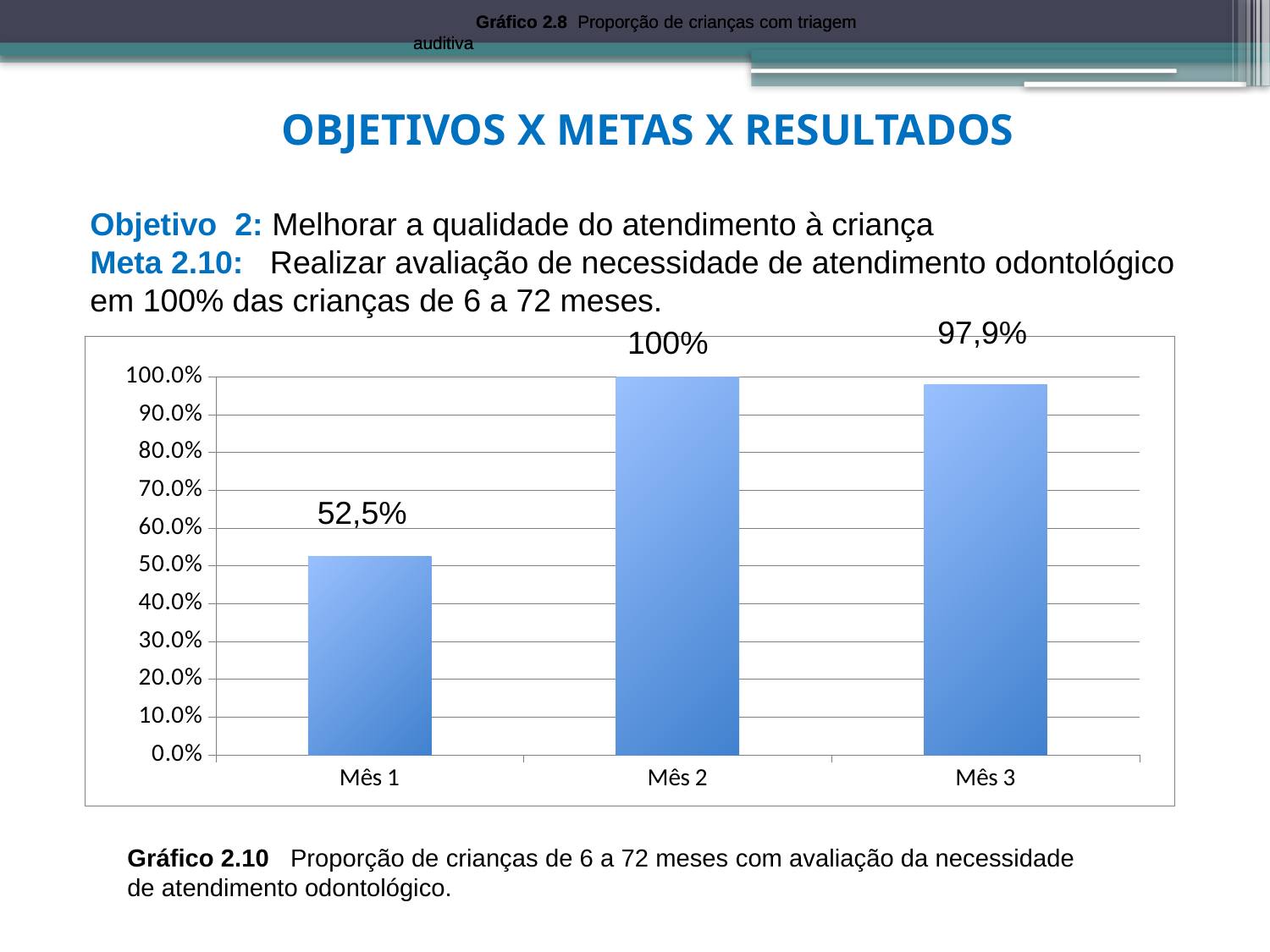
What is the value for Mês 1? 52,5% What is the number of the chart given in the caption below it? Gráfico 2.10 What is the difference between the values for Mês 3 and Mês 1? 45,4% What kind of chart is shown on the slide? bar chart Which month has the highest value? Mês 2 Which month has the lowest value? Mês 1 How many months are shown on the x axis? 3 Is the value for Mês 1 greater or less than 60.0%? less What is the value for Mês 2? 100% What is the difference between the values for Mês 2 and Mês 1? 47,5% What is the value for Mês 3? 97,9% Which is larger, the value for Mês 1 or the value for Mês 3? Mês 3